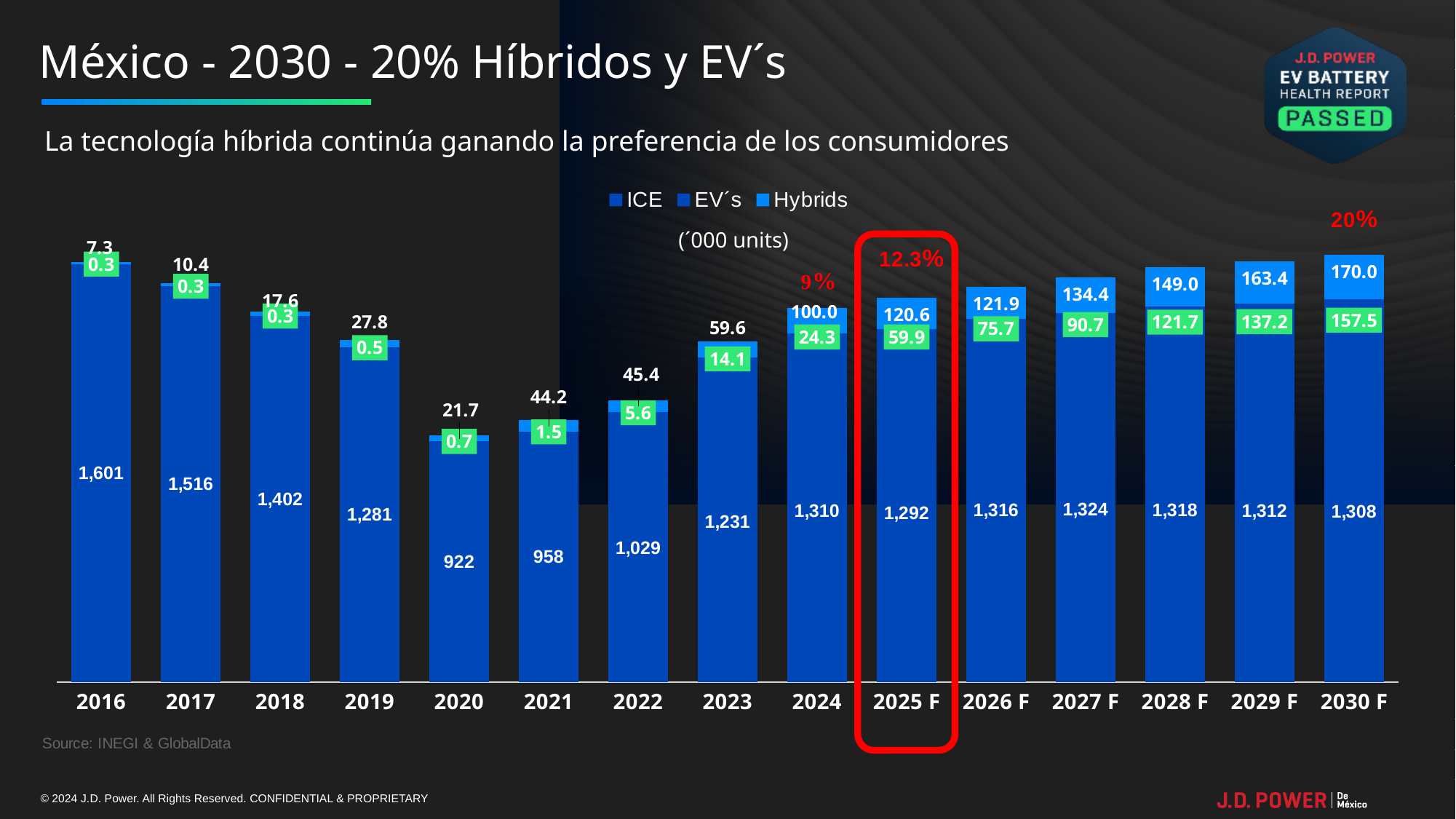
How many series does the legend list? 3 Do the Hybrids values rise or fall from 2024 to 2030 F? Rise What is the ICE value for 2016? 1,601 Which is larger, the ICE value for 2023 or for 2024? 2024 Which year has the lowest ICE value? 2020 What kind of chart is shown on the slide? Stacked bar chart In what units are the values on the chart expressed? '000 units How many years are shown along the x axis? 15 Which year has the highest ICE value? 2016 What is the EV's value for 2025 F? 59.9 What is the difference between the ICE value in 2016 and the ICE value in 2020? 679 What is the Hybrids value for 2030 F? 170.0